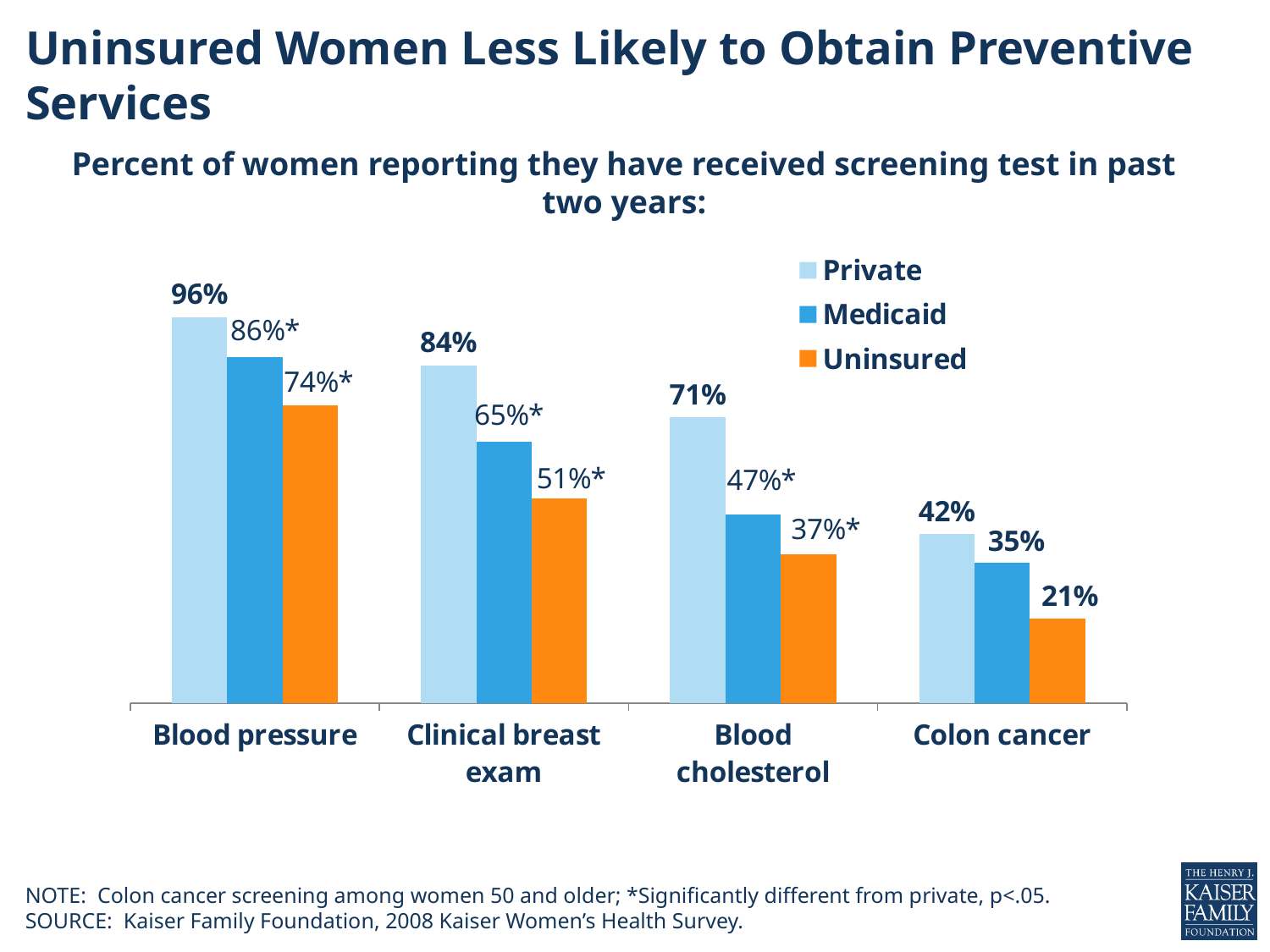
How many series does the legend list? 3 What is the difference between the Private and Uninsured values for blood cholesterol screening? 34 percentage points What is the value for Uninsured women for the clinical breast exam? 51% What percent of privately insured women reported receiving a blood pressure screening? 96% How many screening test categories are shown on the x axis? 4 Which series is shown in orange in the legend? Uninsured Which screening test has the highest value for the Private series? Blood pressure What is the value for Uninsured women for colon cancer screening? 21% Which screening test has the lowest value for the Uninsured series? Colon cancer What is the value for Medicaid women for blood cholesterol screening? 47% Which is larger: the Medicaid value for blood pressure or the Private value for clinical breast exam? Medicaid value for blood pressure (86%) What kind of chart is shown on the slide? Bar chart